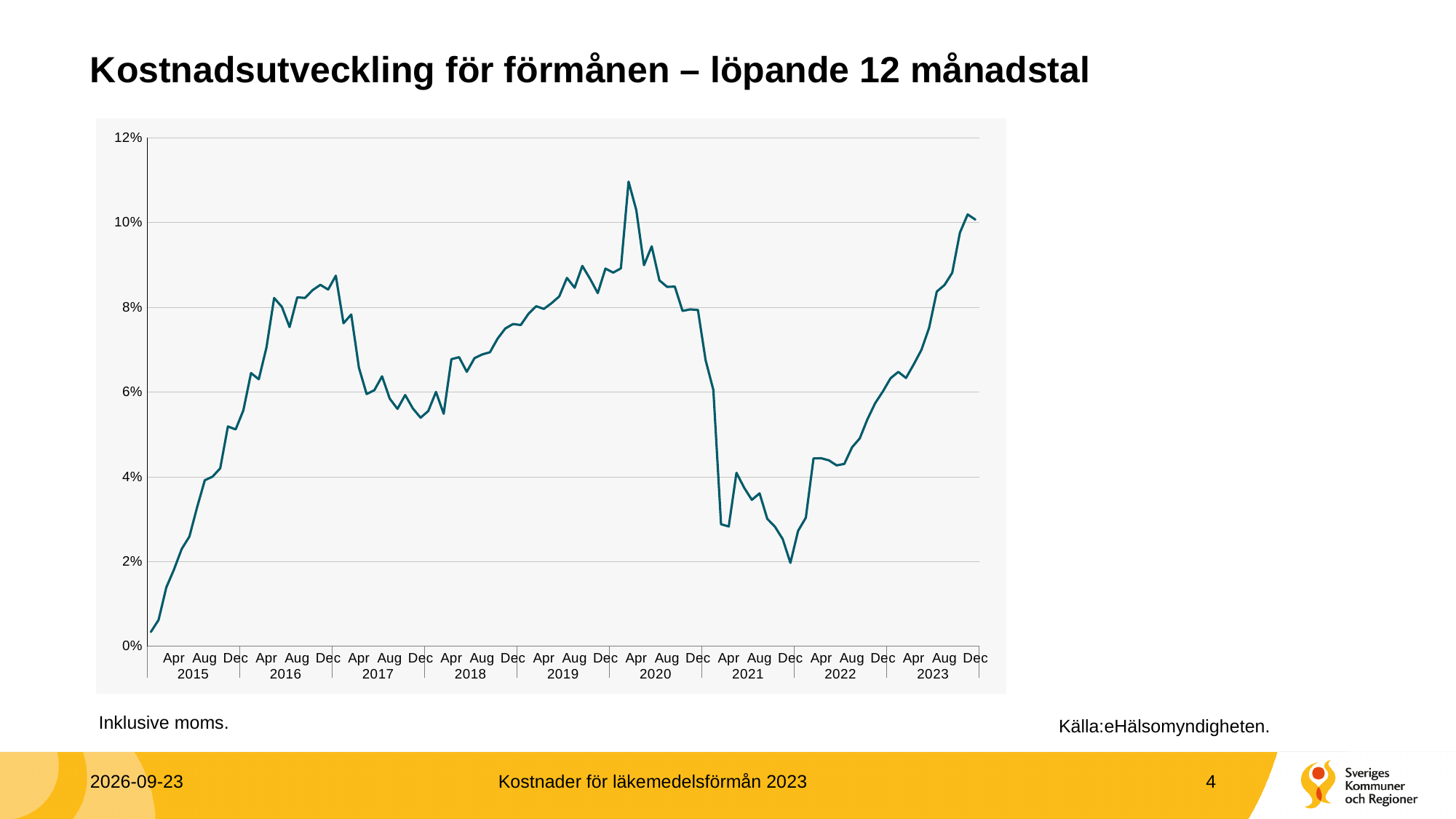
What is the highest value shown on the y axis of the chart? 12% What is the source given for the chart? eHälsomyndigheten Does the line rise or fall between Dec 2021 and Dec 2023? rise Is the value at Dec 2023 greater or less than 8%? greater Is the peak value in Apr 2020 greater or less than 10%? greater In which year does the line reach its lowest point? 2015 What kind of chart is shown on the slide? line chart Does the line rise or fall between Apr 2020 and Apr 2021? fall Is the value at Dec 2021 greater or less than 4%? less In which year does the line reach its highest point? 2020 How many years are labelled along the x axis of the chart? 9 What is the title of the chart on the slide? Kostnadsutveckling för förmånen – löpande 12 månadstal